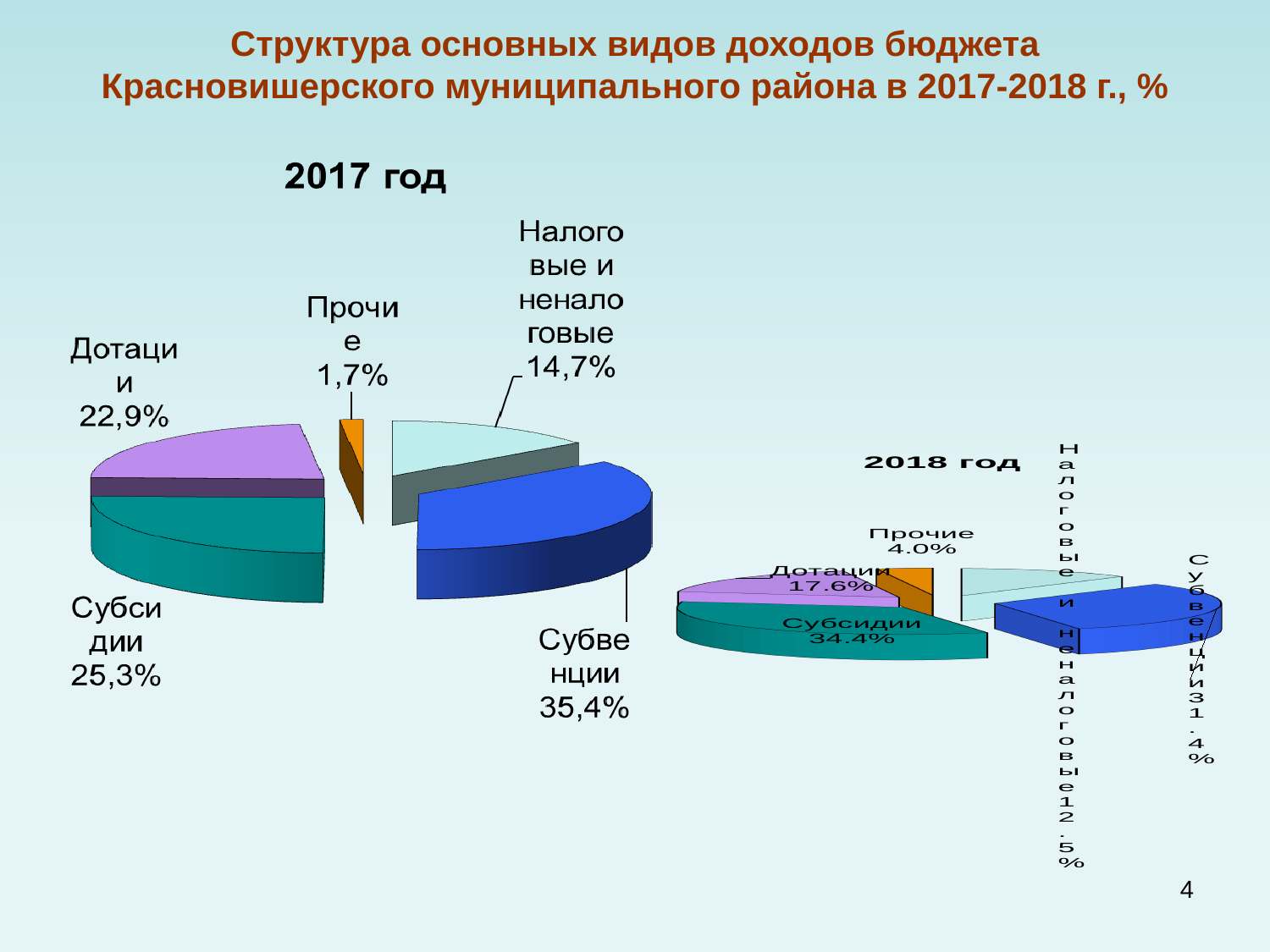
On the 2018 год chart, what is the value for Прочие? 4.0% On the 2017 год chart, what share do Субвенции have? 35,4% How many pie charts are shown on the slide? 2 On the 2017 год chart, which category has the largest share? Субвенции On the 2018 год chart, what is the value for Субсидии? 34.4% On the 2017 год chart, which category has the smallest share? Прочие What kind of chart is the 2017 год chart? Pie chart On the 2017 год chart, how many slices does the pie have? 5 On the 2017 год chart, what is the value for Дотации? 22,9% On the 2018 год chart, which is larger: Дотации or Налоговые и неналоговые? Дотации On the 2018 год chart, what is the difference between Субсидии and Субвенции? 3.0% On the 2017 год chart, what is the difference between Субсидии and Дотации? 2,4%